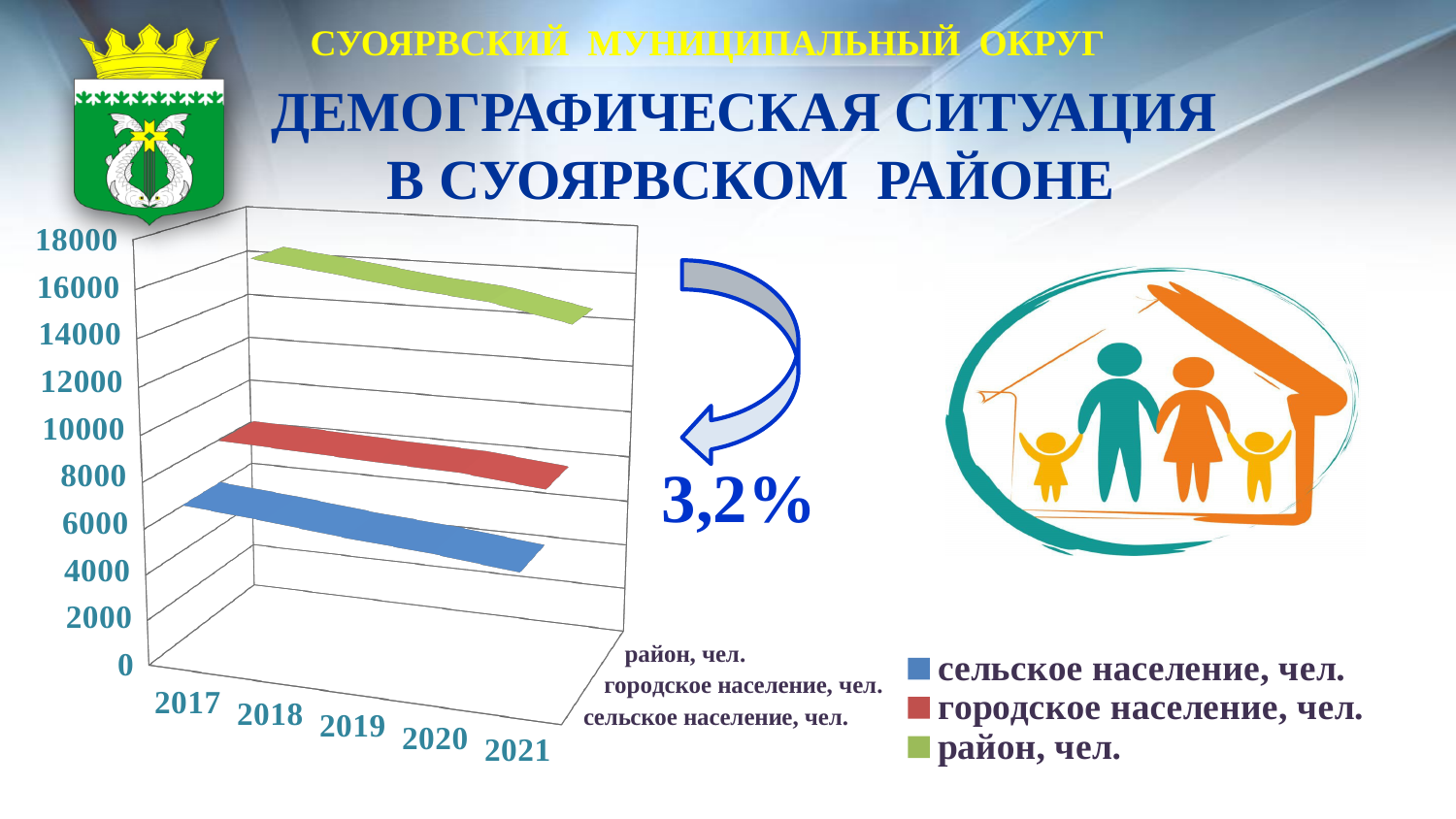
Which is larger in the chart, городское население or сельское население? городское население Which colour represents городское население, чел. in the chart legend? red Do the values for сельское население, чел. rise or fall from 2017 to 2021? fall Which years are shown on the x axis of the chart? 2017, 2018, 2019, 2020, 2021 How many series does the chart legend list? 3 What kind of chart is shown on the slide? 3D line (ribbon) chart How many years are shown on the x axis of the chart? 5 Do the values for район, чел. rise or fall from 2017 to 2021? fall What is the maximum value shown on the vertical axis of the chart? 18000 Which series has the lowest values in the chart? сельское население, чел. Is the value for район, чел. in 2017 greater or less than 10000? greater Which series has the highest values in the chart? район, чел.